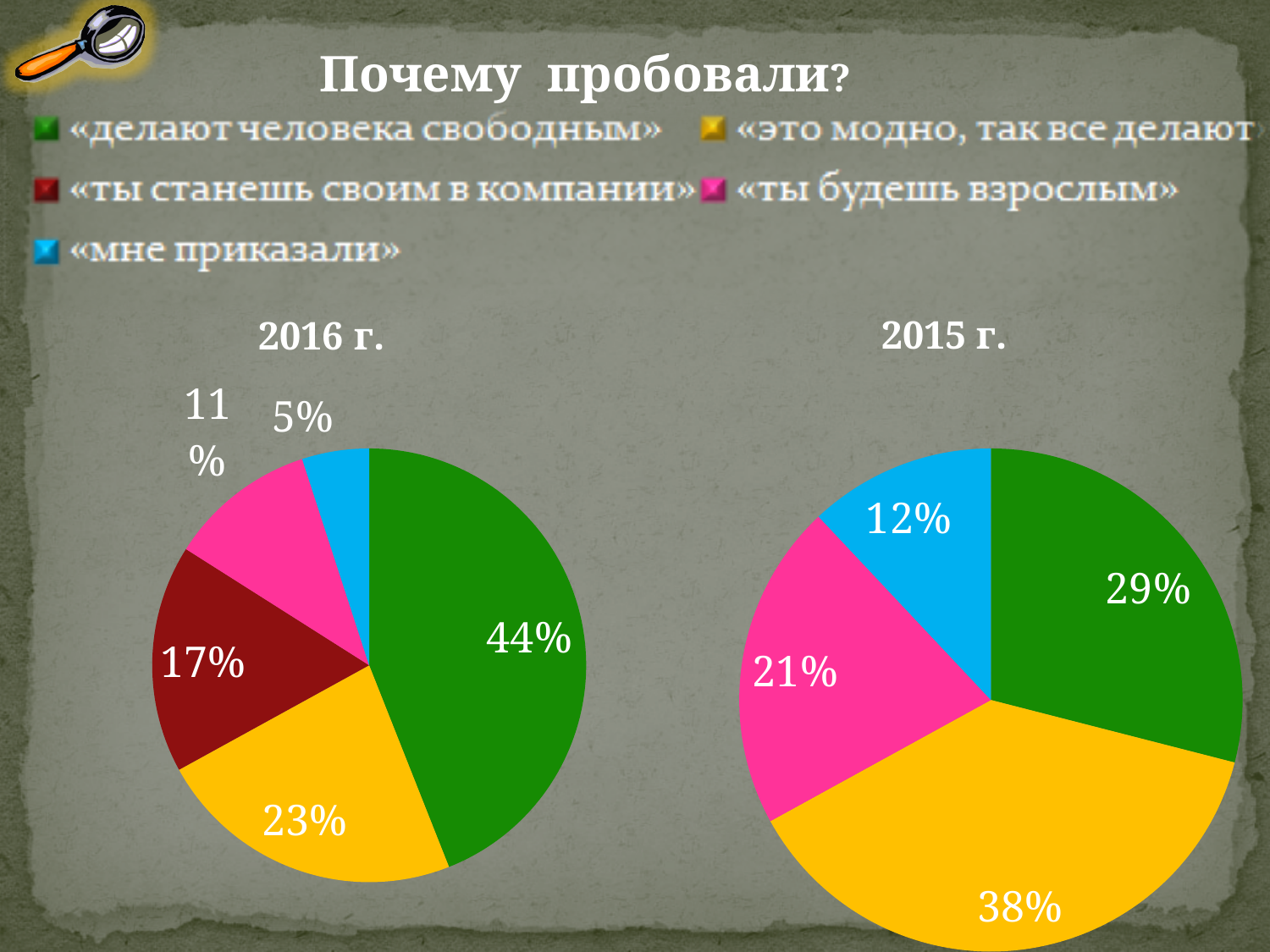
How many slices does the 2015 г. pie chart have? 4 In the 2015 г. pie chart, which category has the largest share? «это модно, так все делают» In the 2016 г. pie chart, which category has the largest share? «делают человека свободным» What is the difference between the share for «ты будешь взрослым» in the 2015 г. chart and in the 2016 г. chart? 10% In the 2016 г. pie chart, which category has the smallest share? «мне приказали» In the 2015 г. pie chart, what share is shown for «мне приказали»? 12% In the 2016 г. pie chart, what share is shown for «делают человека свободным»? 44% What type of chart is used for the 2016 г. data? Pie chart In the 2016 г. pie chart, which is larger: the share for «это модно, так все делают» or for «ты станешь своим в компании»? «это модно, так все делают» How many slices does the 2016 г. pie chart have? 5 In the 2016 г. pie chart, what share is shown for «ты станешь своим в компании»? 17% In the 2015 г. pie chart, what share is shown for «это модно, так все делают»? 38%